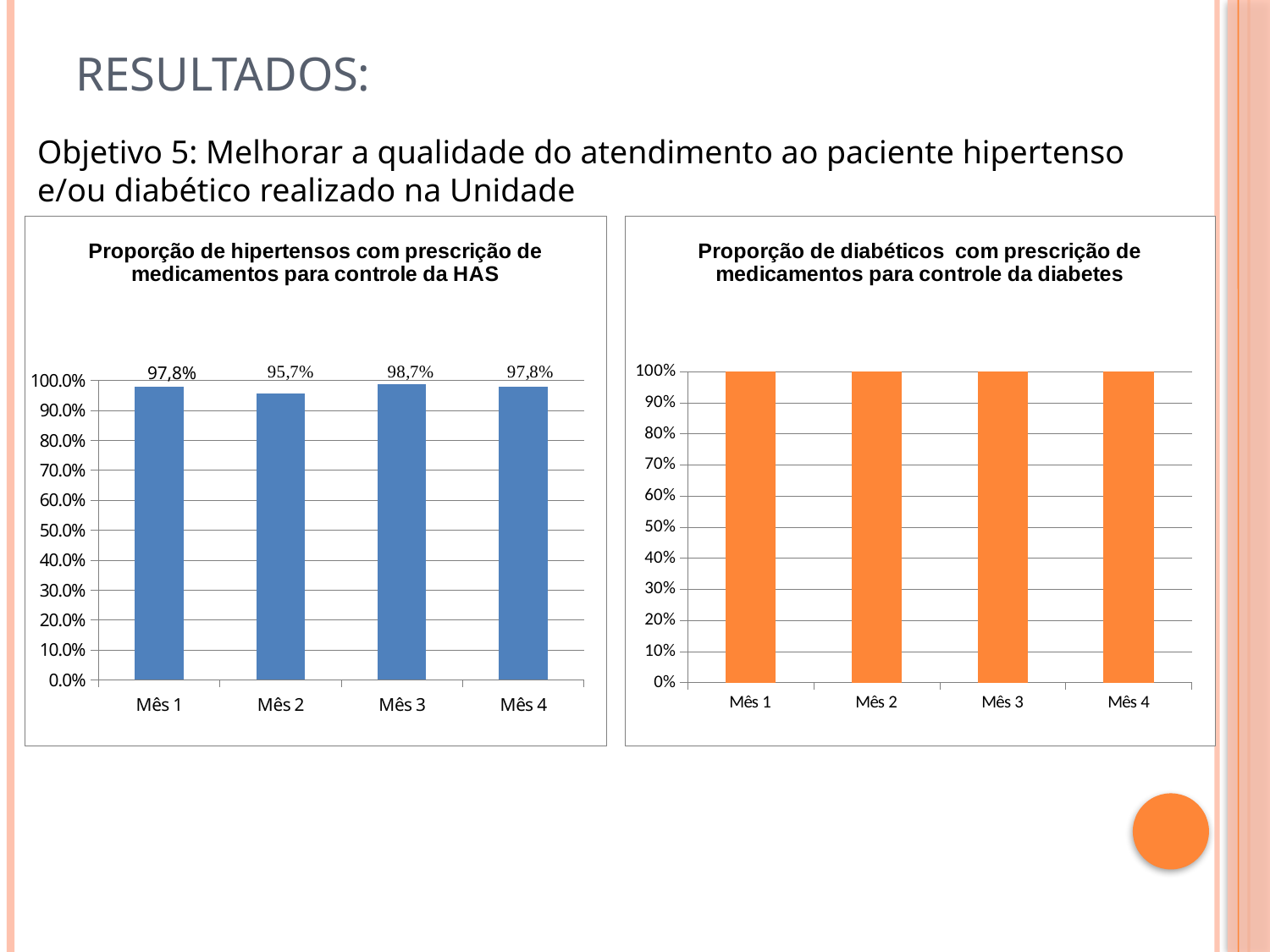
In the right chart (Proporção de diabéticos com prescrição de medicamentos para controle da diabetes), what is the value for Mês 1? 100% What colour are the bars in the right chart (Proporção de diabéticos com prescrição de medicamentos para controle da diabetes)? Orange In the left chart (Proporção de hipertensos com prescrição de medicamentos para controle da HAS), what is the value for Mês 2? 95,7% In the left chart (Proporção de hipertensos com prescrição de medicamentos para controle da HAS), what is the value for Mês 1? 97,8% In the left chart (Proporção de hipertensos com prescrição de medicamentos para controle da HAS), which is larger, the value for Mês 2 or Mês 4? Mês 4 In the right chart (Proporção de diabéticos com prescrição de medicamentos para controle da diabetes), is the value for Mês 3 greater or less than 90%? greater What kind of chart is the right chart (Proporção de diabéticos com prescrição de medicamentos para controle da diabetes)? Bar chart In the left chart (Proporção de hipertensos com prescrição de medicamentos para controle da HAS), how many months are shown on the x axis? 4 In the left chart (Proporção de hipertensos com prescrição de medicamentos para controle da HAS), what is the value for Mês 3? 98,7% In the left chart (Proporção de hipertensos com prescrição de medicamentos para controle da HAS), which month has the lowest value? Mês 2 In the left chart (Proporção de hipertensos com prescrição de medicamentos para controle da HAS), which month has the highest value? Mês 3 In the left chart (Proporção de hipertensos com prescrição de medicamentos para controle da HAS), what is the difference between the values for Mês 3 and Mês 2? 3,1%